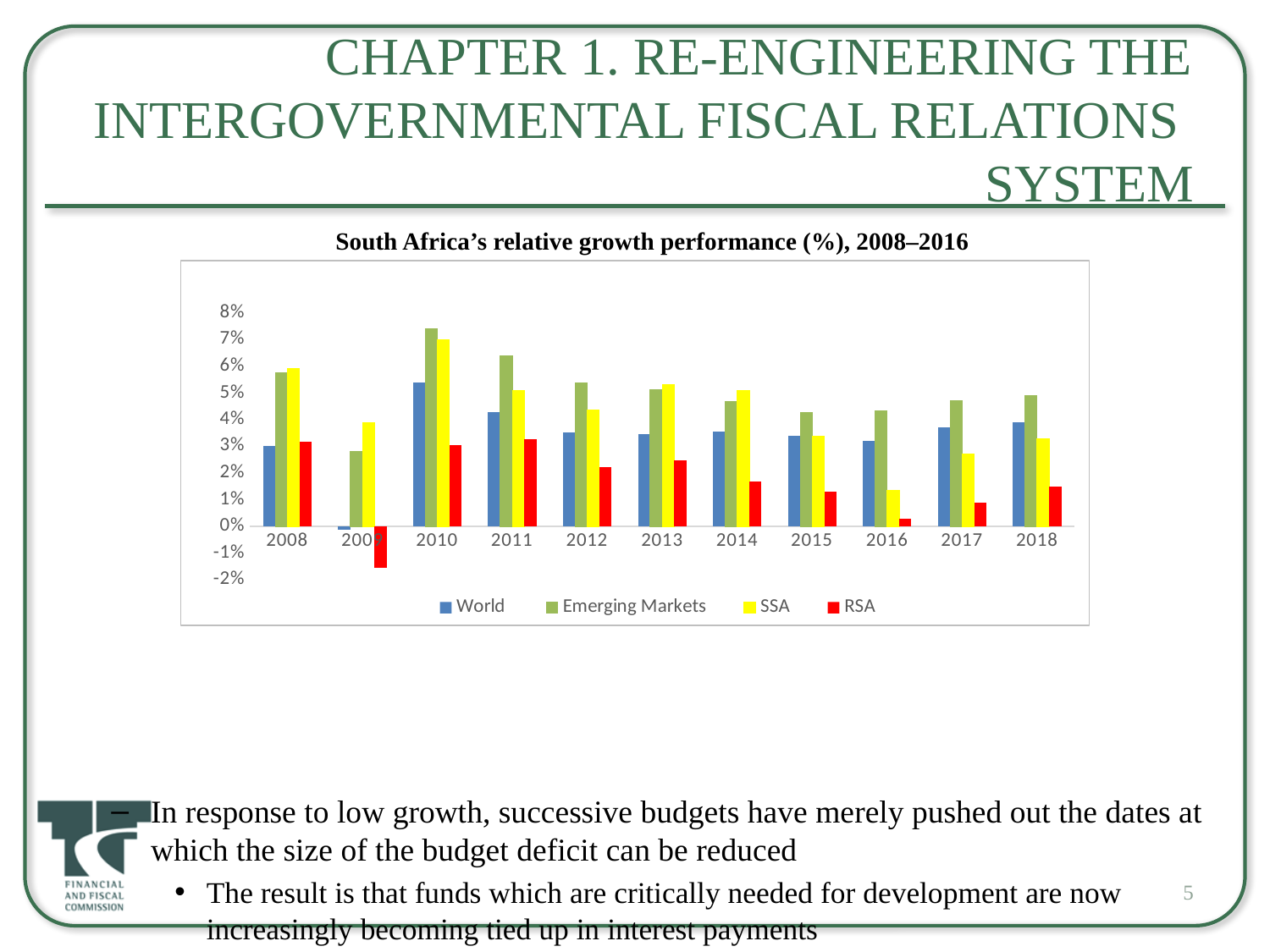
Is the value for World in 2010 greater or less than 5%? greater Which colour represents the RSA series in the chart? red Is the value for RSA in 2009 greater or less than 0%? less In 2010, which is larger: the Emerging Markets value or the RSA value? Emerging Markets How many series does the chart's legend list? 4 In which year is the Emerging Markets value highest? 2010 In which year is the RSA value lowest? 2009 What is the title of the chart? South Africa's relative growth performance (%), 2008–2016 How many years are shown on the x axis of the chart? 11 What kind of chart is shown on the slide? bar chart Is the value for RSA in 2016 greater or less than 1%? less